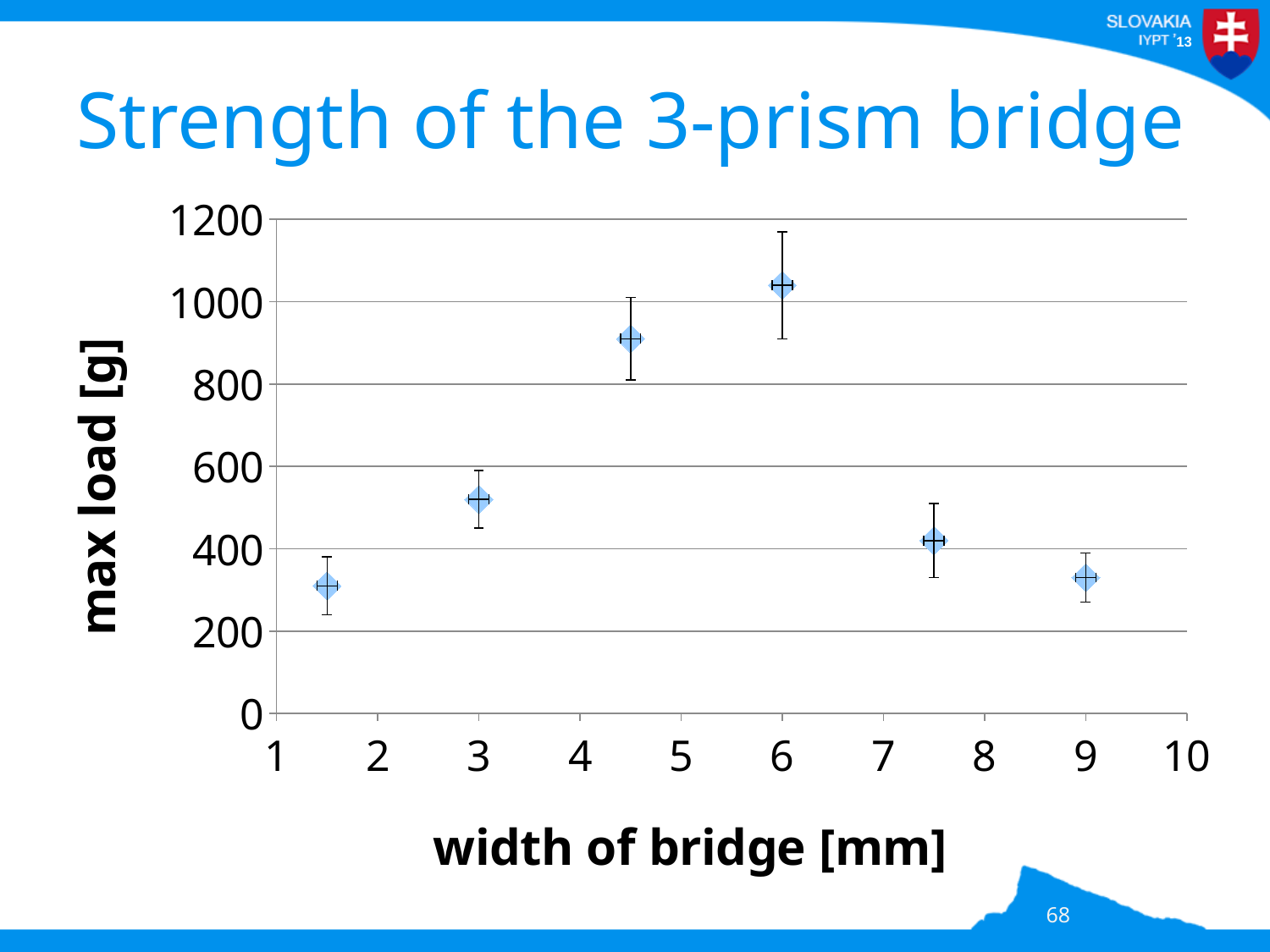
Is the max load for a bridge width of 7.5 mm greater or less than 600 g? less Is the max load for a bridge width of 3 mm greater or less than 600 g? less Is the max load for a bridge width of 1.5 mm greater or less than 400 g? less What is the title of the chart? Strength of the 3-prism bridge At which width of bridge is the max load highest? 6 mm What is the label of the y axis? max load [g] Do the max load values rise or fall as the width of bridge increases from 6 mm to 9 mm? fall How many data points are plotted on the chart? 6 What kind of chart is shown on the slide? scatter chart Which has a higher max load: a bridge width of 3 mm or 4.5 mm? 4.5 mm